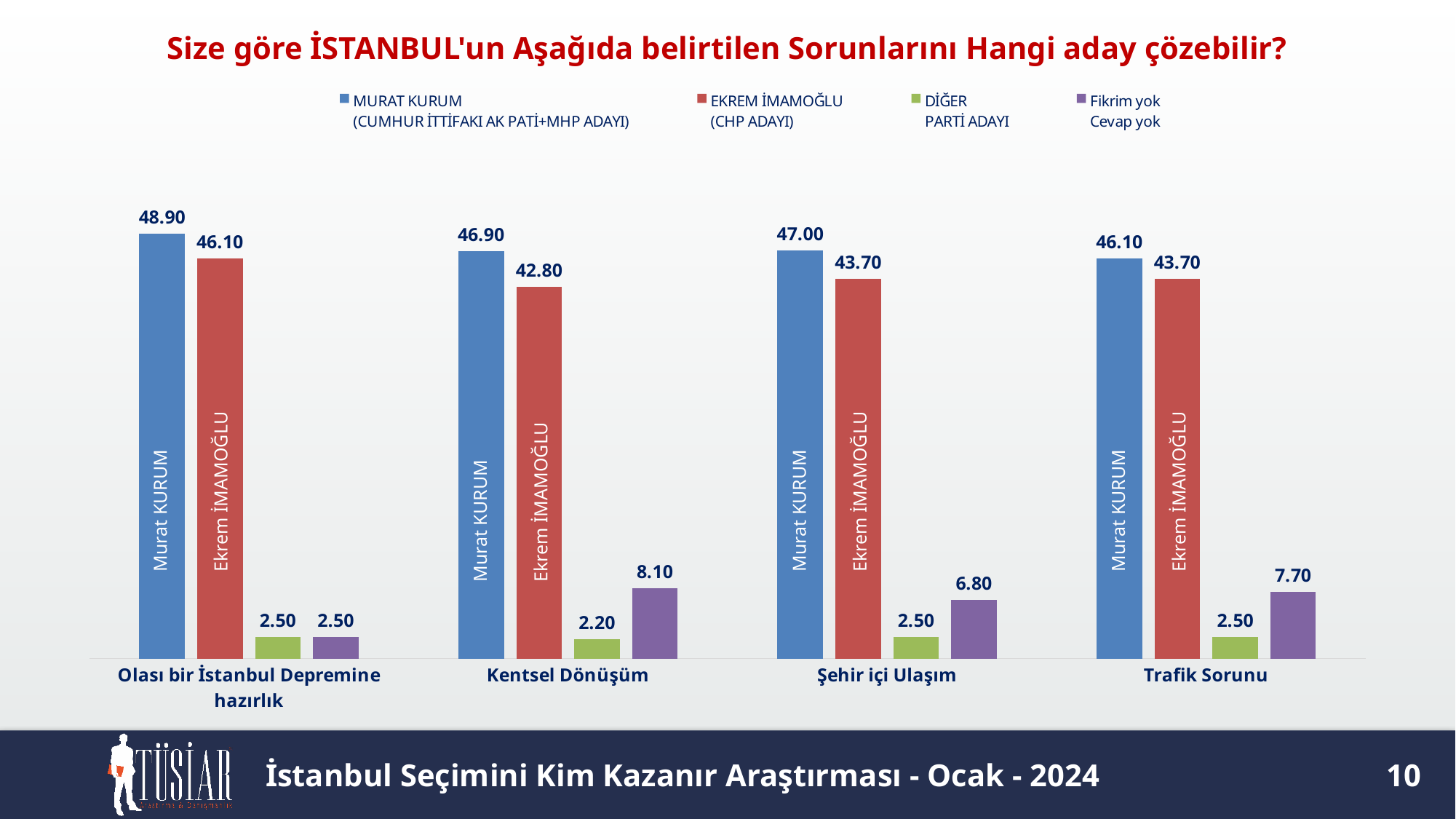
What kind of chart is shown on the slide? Bar chart In which category does 'Fikrim yok Cevap yok' have its lowest value? Olası bir İstanbul Depremine hazırlık What is the difference between Murat Kurum's and Ekrem İmamoğlu's values in the 'Trafik Sorunu' category? 2.40 How many series does the legend list? 4 What value is shown for 'DİĞER PARTİ ADAYI' in the 'Kentsel Dönüşüm' category? 2.20 What value is shown for Murat Kurum in the 'Olası bir İstanbul Depremine hazırlık' category? 48.90 How many problem categories are shown on the x axis? 4 What colour are the bars for Ekrem İmamoğlu? Red What value is shown for 'Fikrim yok Cevap yok' in the 'Şehir içi Ulaşım' category? 6.80 Which is larger in the 'Kentsel Dönüşüm' category: the value for Murat Kurum or for Ekrem İmamoğlu? Murat Kurum What value is shown for Ekrem İmamoğlu in the 'Kentsel Dönüşüm' category? 42.80 In which category does Murat Kurum have his highest value? Olası bir İstanbul Depremine hazırlık